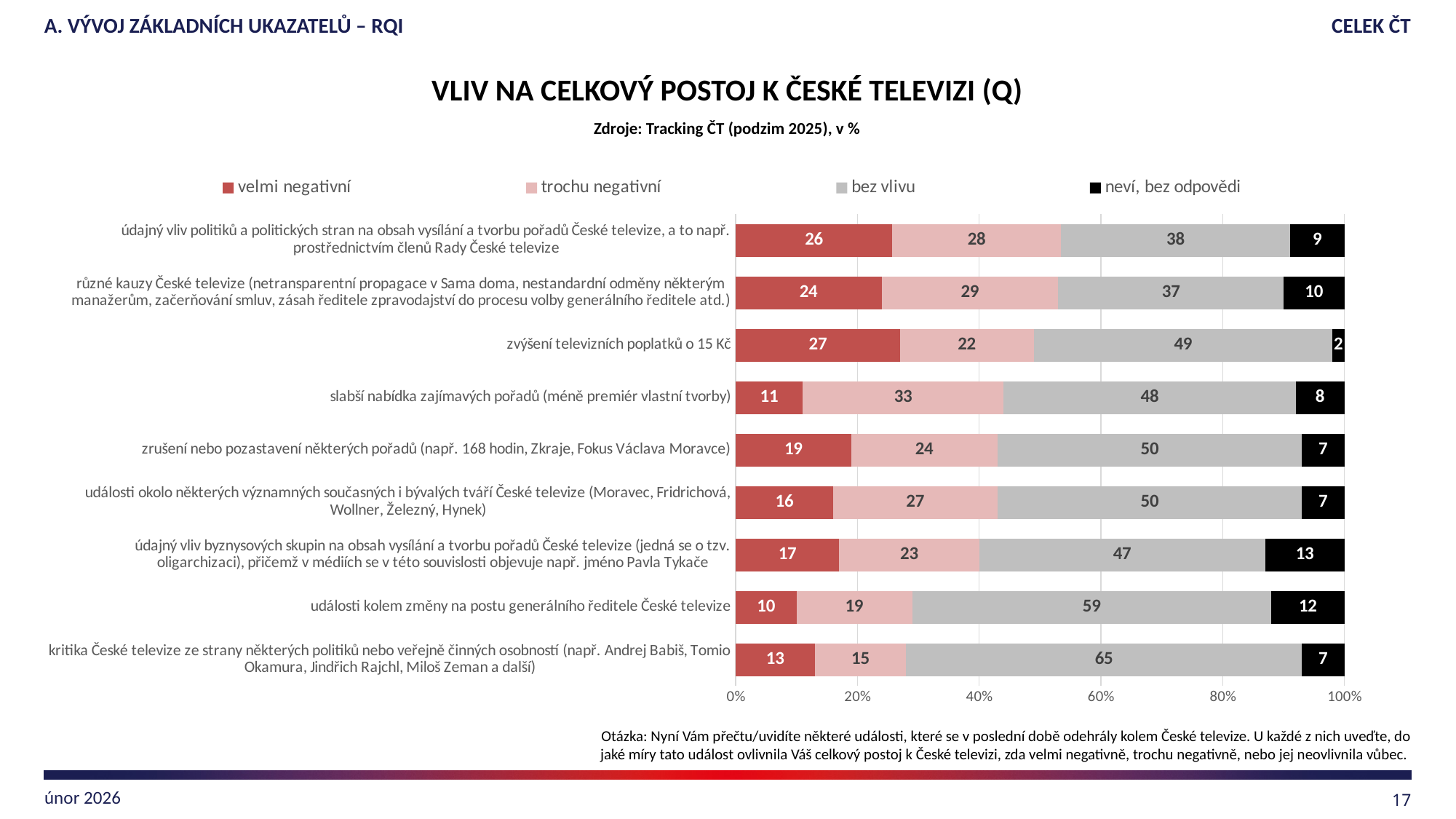
What is the 'neví, bez odpovědi' value for 'údajný vliv byznysových skupin na obsah vysílání a tvorbu pořadů České televize'? 13 How many series does the legend list? 4 What is the source stated under the chart title? Tracking ČT (podzim 2025), v % Which category has the highest 'bez vlivu' value? kritika České televize ze strany některých politiků nebo veřejně činných osobností What kind of chart is shown on the slide? stacked bar chart Which is larger: the 'velmi negativní' value for 'údajný vliv politiků a politických stran' or for 'různé kauzy České televize'? údajný vliv politiků a politických stran What is the total of the stacked bar for 'zrušení nebo pozastavení některých pořadů'? 100 How many categories (events) are plotted in the chart? 9 What is the 'velmi negativní' value for 'zvýšení televizních poplatků o 15 Kč'? 27 What is the difference between the 'trochu negativní' values for 'slabší nabídka zajímavých pořadů' and 'kritika České televize ze strany některých politiků'? 18 What is the 'bez vlivu' value for 'události kolem změny na postu generálního ředitele České televize'? 59 Which category has the lowest 'velmi negativní' value? události kolem změny na postu generálního ředitele České televize